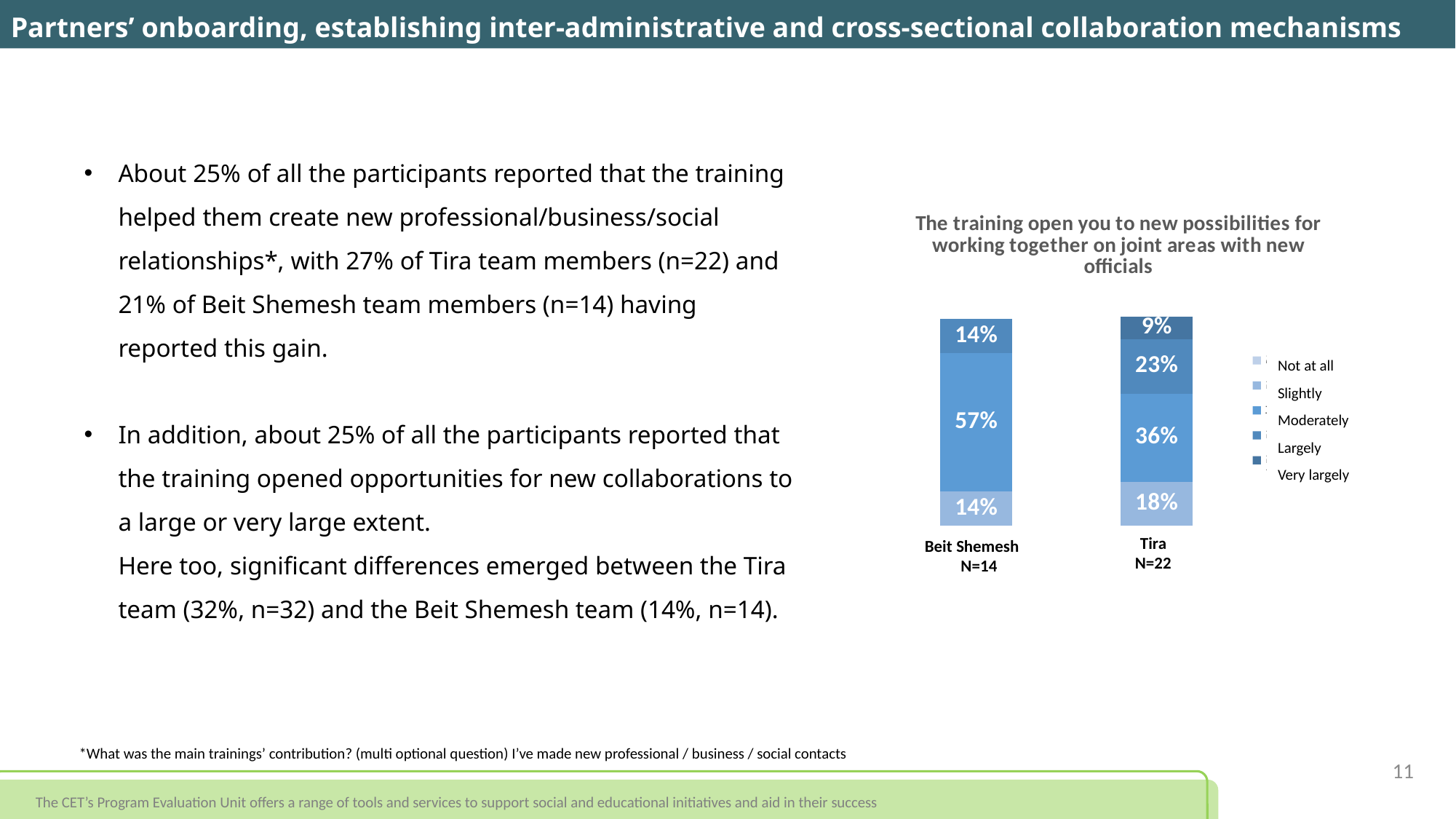
Which bar has the larger single segment, Beit Shemesh or Tira? Beit Shemesh What is the value of the largest segment in the Beit Shemesh bar? 57% What is the smallest labelled segment in the Tira bar? 9% What is the value of the topmost segment in the Tira bar? 9% What is the title of the chart? The training open you to new possibilities for working together on joint areas with new officials What is the value of the bottom segment in the Tira bar? 18% What is the value of the bottom segment in the Beit Shemesh bar? 14% How many bars (groups) are plotted in the chart? 2 What is the difference between the largest segment of the Beit Shemesh bar (57%) and the largest segment of the Tira bar (36%)? 21 percentage points What sample size (N) is shown for the Tira bar? N=22 How many series does the chart's legend list? 5 What type of chart is shown on the slide? Stacked bar chart